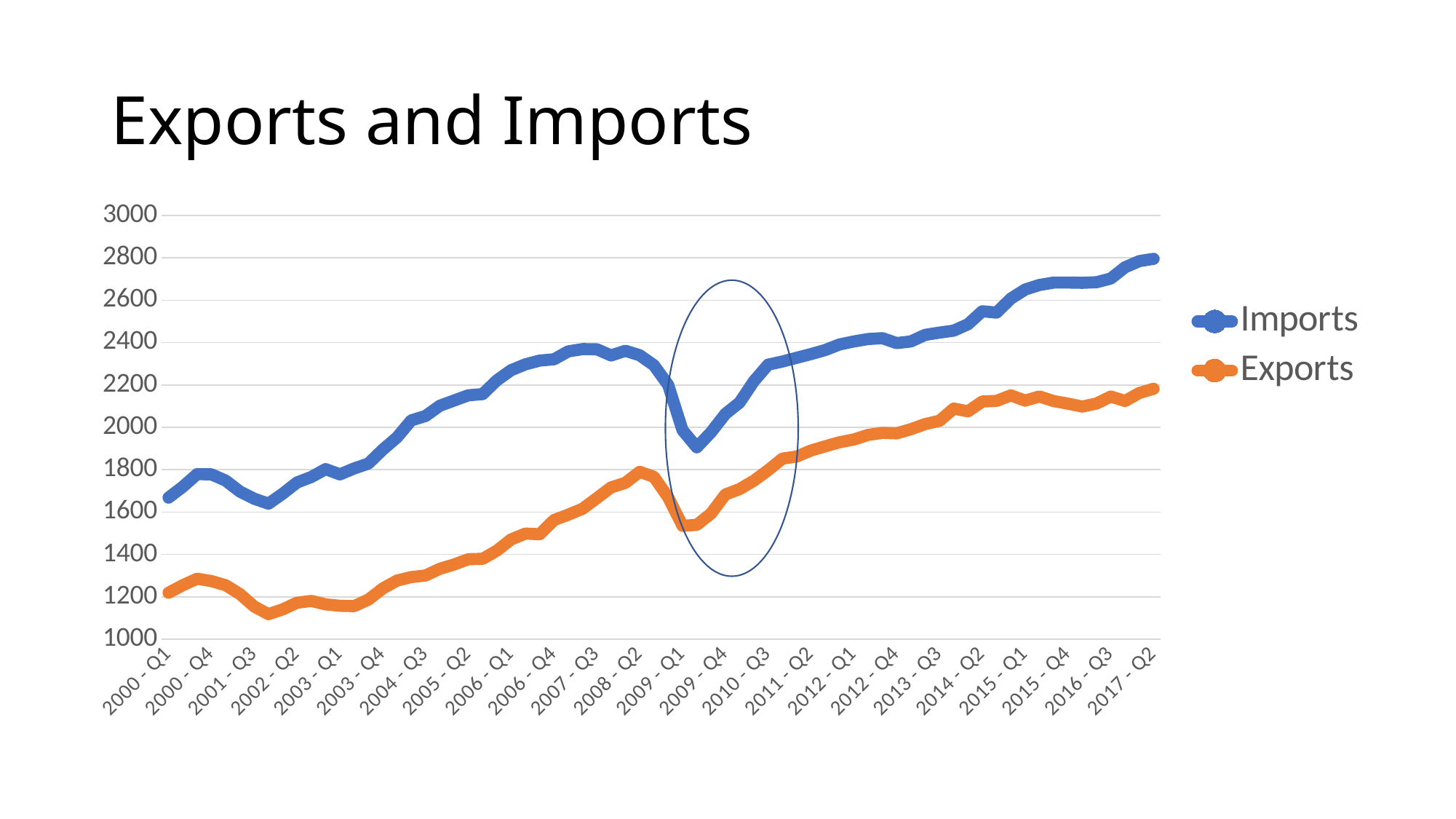
At which quarter does the Imports series reach its highest value? 2017 - Q2 At 2009 - Q1, which series has the larger value, Imports or Exports? Imports How many series does the legend list? 2 Which series has the higher values throughout the whole period? Imports Which series is drawn in blue? Imports Is the value for Exports at 2000 - Q1 greater or less than 1400? less Is the value for Exports at 2017 - Q2 greater or less than 2000? greater What kind of chart is shown on the slide? line chart Overall, do the Exports values rise or fall from 2000 - Q1 to 2017 - Q2? rise Is the value for Imports at 2017 - Q2 greater or less than 2600? greater What is the title of the slide? Exports and Imports